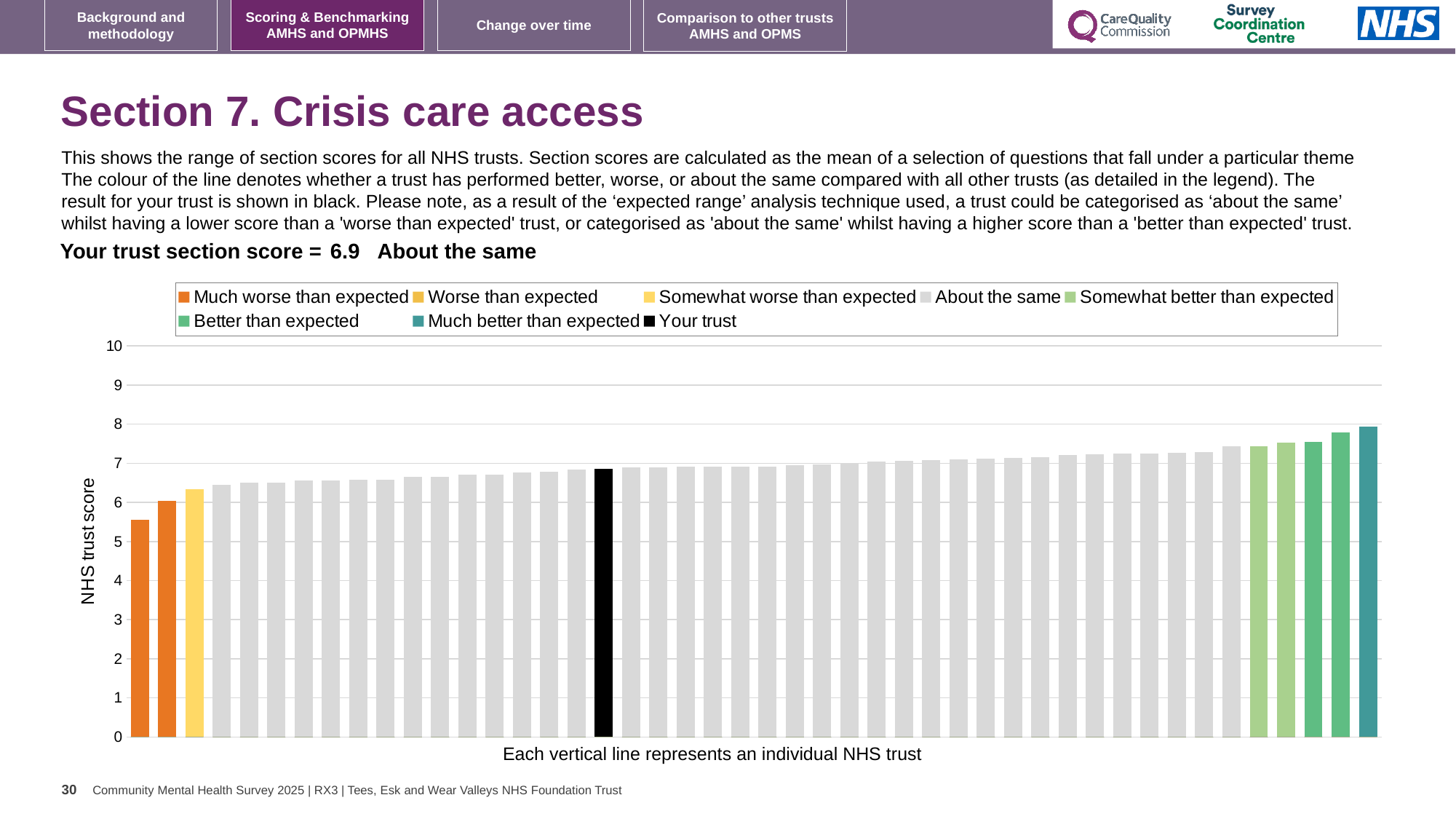
Is the value of the rightmost bar greater or less than 7? greater Do the bar values rise or fall from left to right along the x axis? rise Which legend category does the shortest bar in the chart belong to? Much worse than expected Is the value of the leftmost bar greater or less than 6? less Which legend category does the tallest bar in the chart belong to? Much better than expected Is the value of the black 'Your trust' bar greater or less than 6? greater What is the label on the vertical axis of the chart? NHS trust score Which is larger, the leftmost bar or the rightmost bar? the rightmost bar What is the section score for your trust shown on the slide? 6.9 What kind of chart is shown on the slide? bar chart How many entries does the chart legend list? 8 How many bars are coloured as 'Much worse than expected'? 2